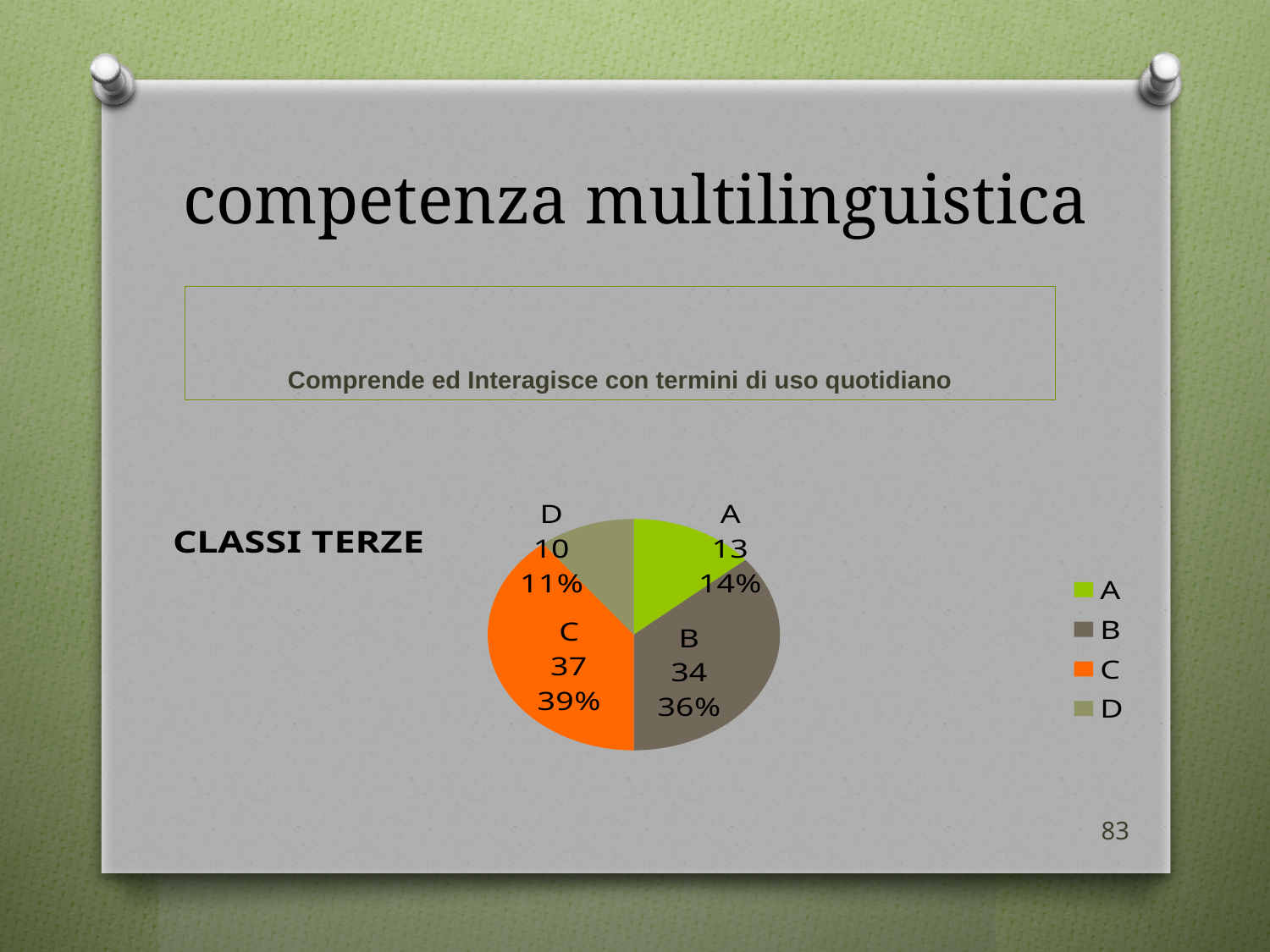
What percentage share does category B have in the pie chart? 36% What is the difference between the values for A and D in the pie chart? 3 What kind of chart is shown on the slide? pie chart What colour is the slice for category C in the pie chart? orange What is the difference between the values for C and B in the pie chart? 3 Which category has the smallest slice in the pie chart? D Which category has the largest slice in the pie chart? C What is the value for category A in the pie chart? 13 How many categories does the pie chart have? 4 Which is larger in the pie chart, the value for B or the value for A? B What is the value for category C in the pie chart? 37 What percentage share does category D have in the pie chart? 11%